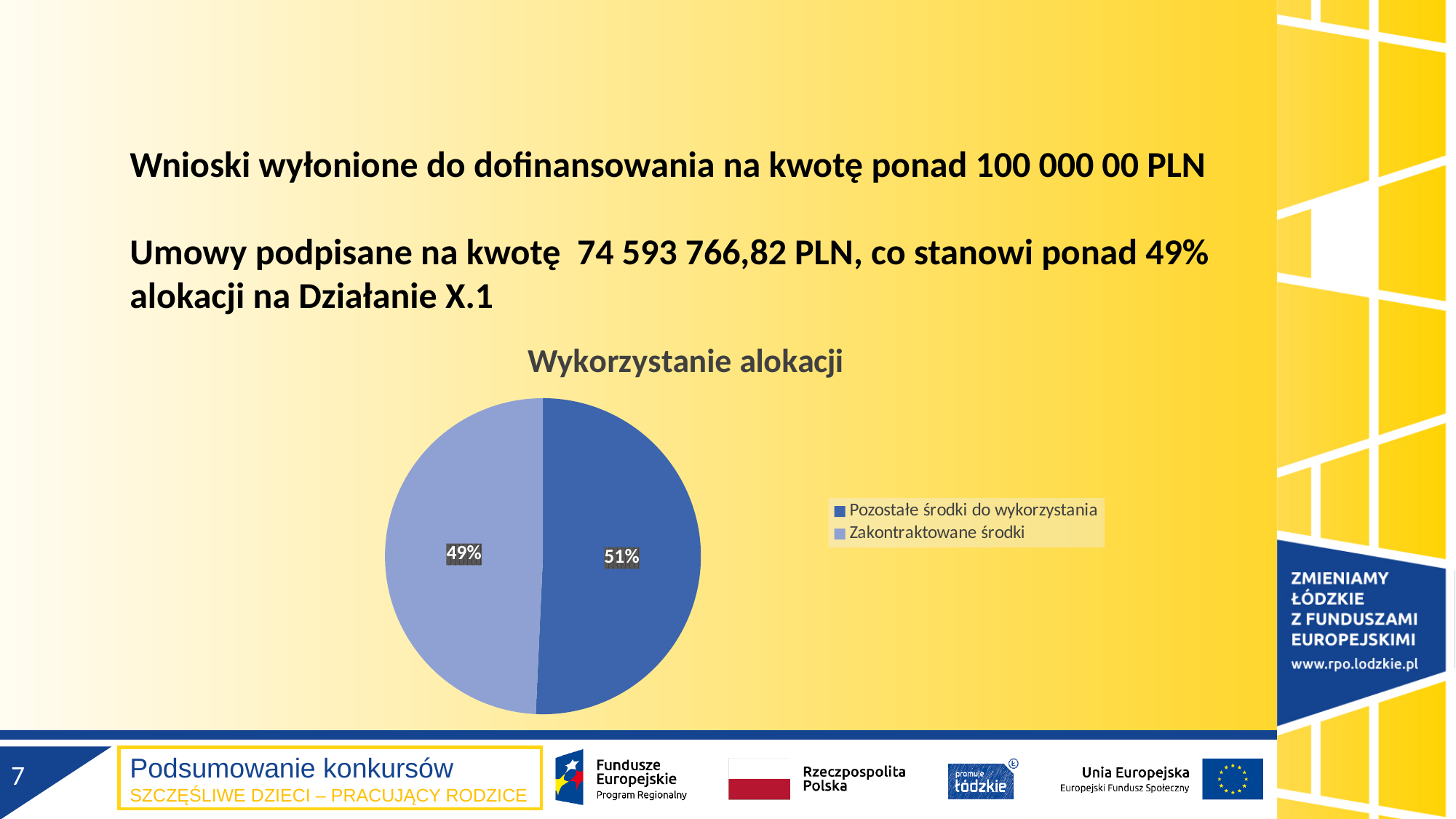
Which is larger in the pie chart: "Pozostałe środki do wykorzystania" or "Zakontraktowane środki"? Pozostałe środki do wykorzystania What share of the pie is labelled "Pozostałe środki do wykorzystania"? 51% Which slice of the pie chart is the smallest? Zakontraktowane środki Which slice of the pie chart is the largest? Pozostałe środki do wykorzystania What kind of chart is shown under the title "Wykorzystanie alokacji"? pie chart What share of the pie is labelled "Zakontraktowane środki"? 49% How many slices does the pie chart have? 2 What is the title of the chart on the slide? Wykorzystanie alokacji What is the difference in percentage points between the "Pozostałe środki do wykorzystania" slice and the "Zakontraktowane środki" slice? 2% How many entries does the legend of the pie chart list? 2 Which legend entry is shown in the lighter blue colour in the pie chart? Zakontraktowane środki